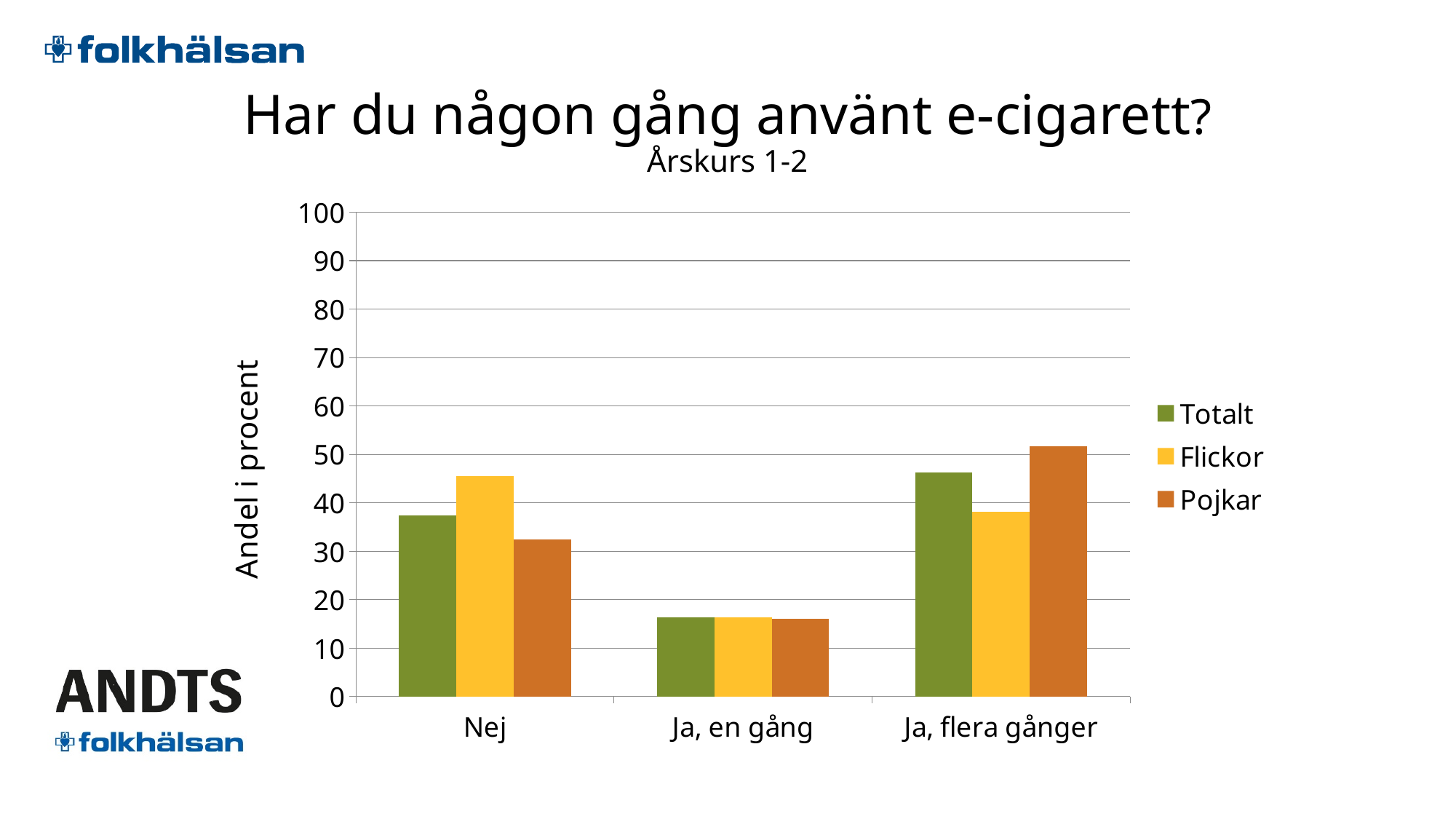
Which series has the lowest value in the Nej category? Pojkar Which series has the highest value in the Ja, flera gånger category? Pojkar What is the label on the vertical axis? Andel i procent Is the value for Pojkar in the Ja, flera gånger category greater or less than 40? greater Is the value for Totalt in the Ja, en gång category greater or less than 20? less Is the value for Totalt in the Nej category greater or less than 40? less What kind of chart is shown on the slide? bar chart Which series has the highest value in the Nej category? Flickor How many series does the legend list? 3 How many categories are shown on the x axis? 3 For Flickor, which is larger: the value for Nej or the value for Ja, flera gånger? Nej